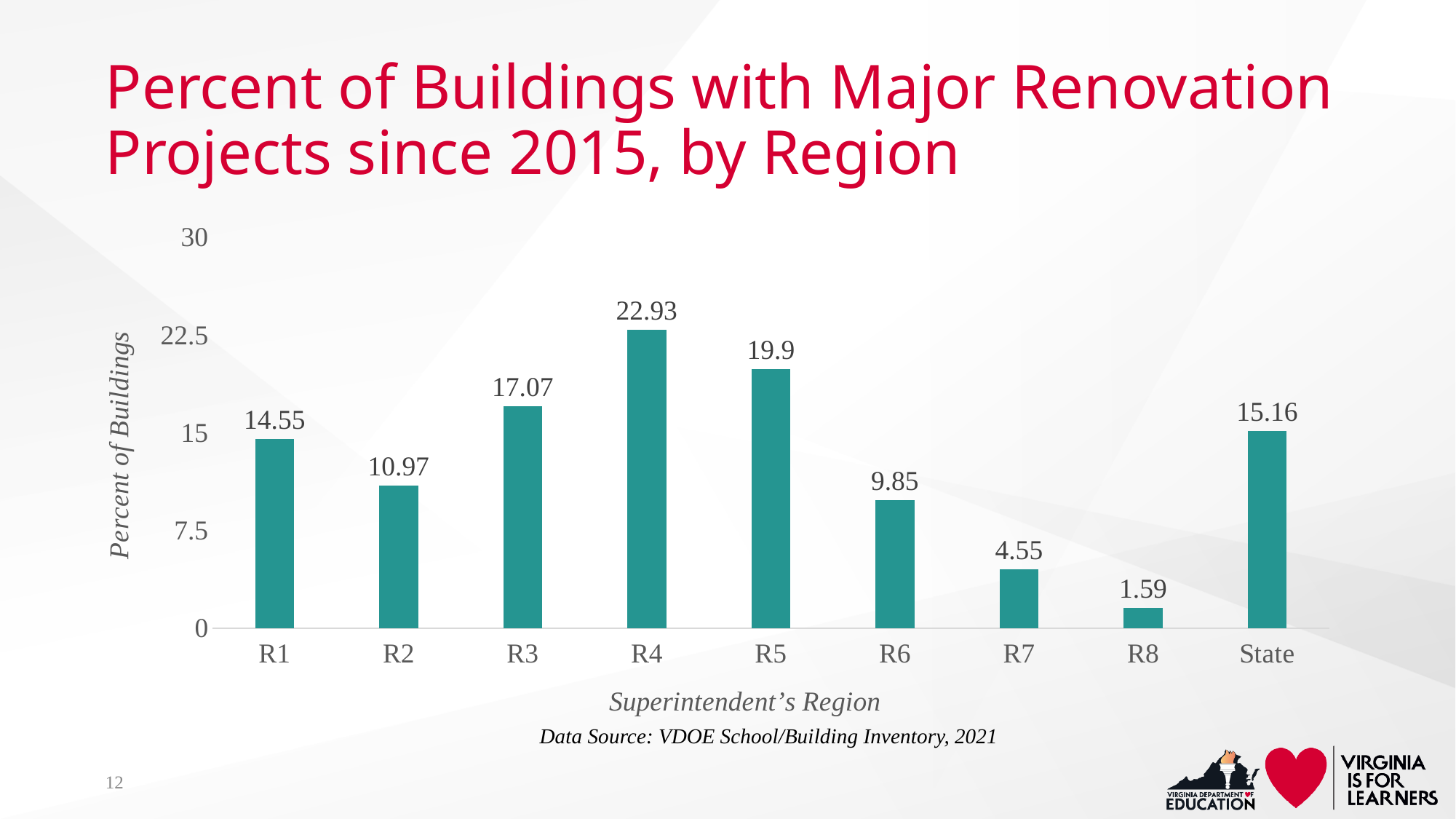
What is the value for State? 15.16 What is the label of the x axis? Superintendent's Region Which region has the lowest percent of buildings with major renovation projects? R8 What is the label of the y axis? Percent of Buildings Which is larger, the value for R1 or the value for State? State What is the difference between the values for R4 and R5? 3.03 What is the value for R4? 22.93 Is the value for R3 greater or less than 15? greater What is the value for R8? 1.59 Which region has the highest percent of buildings with major renovation projects? R4 What kind of chart is shown on the slide? bar chart How many categories are shown on the x axis? 9